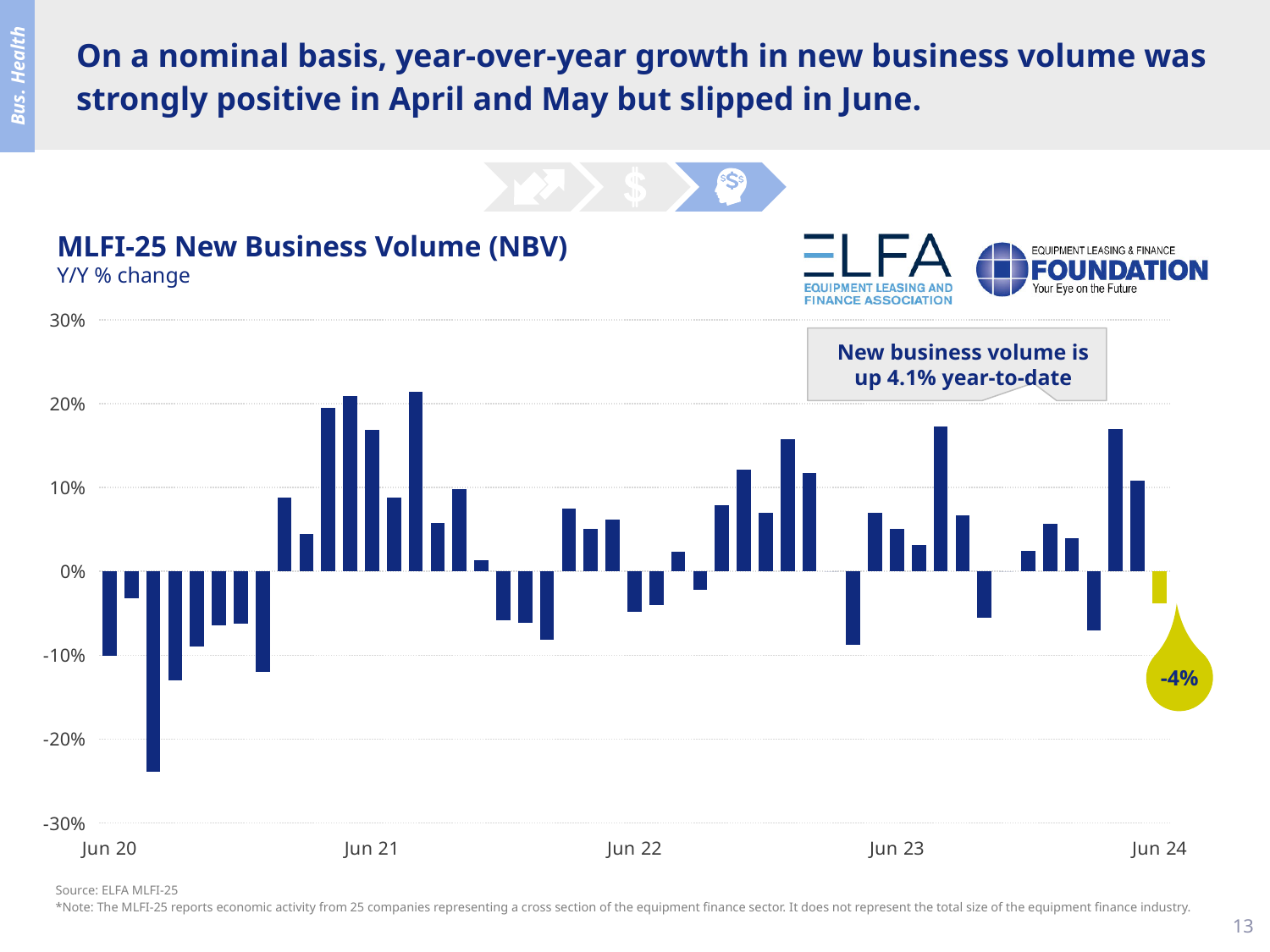
Is the lowest bar on the chart greater or less than -20%? less Which is larger, the value for Jun 21 or the value for Jun 24? Jun 21 Is the value for Jun 20 greater or less than 0%? less Is the value for Jun 21 greater or less than 10%? greater What kind of chart is used to show MLFI-25 New Business Volume? Bar chart According to the callout on the chart, by how much is new business volume up year-to-date? 4.1% What is the Y/Y % change in new business volume shown for Jun 24? -4% How many year labels are shown on the x axis? 5 Do the values rise or fall from Jun 20 to Jun 21? Rise